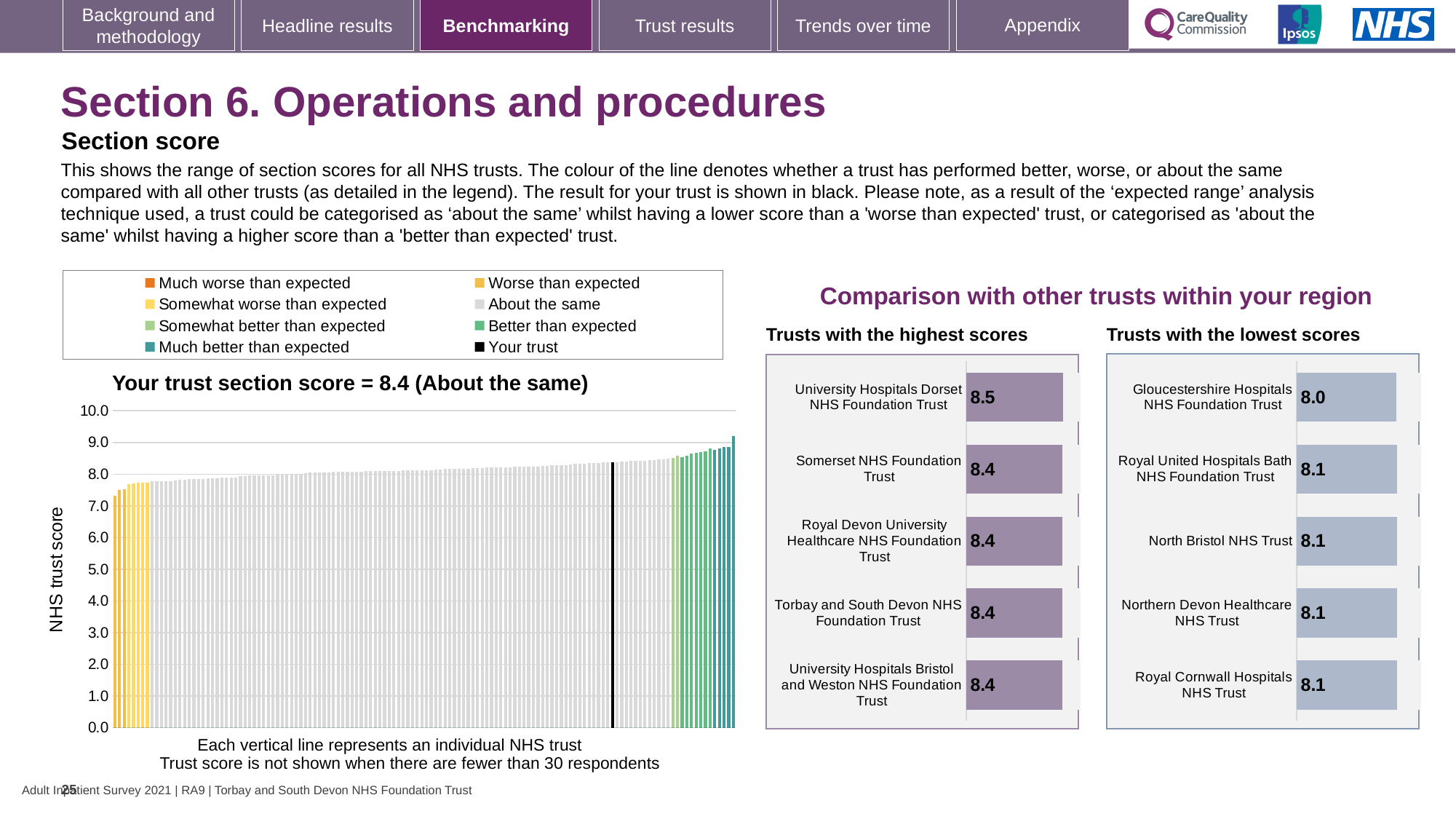
How many trusts are shown in the 'Trusts with the lowest scores' chart? 5 In the 'Your trust section score' chart, is the value of the rightmost (highest) bar greater or less than 8.0? greater In the 'Trusts with the highest scores' chart, what is the difference between the scores of University Hospitals Dorset NHS Foundation Trust and Somerset NHS Foundation Trust? 0.1 In the 'Your trust section score' chart, is the value of the leftmost (lowest) bar greater or less than 8.0? less In the 'Trusts with the highest scores' chart, which trust has the highest score? University Hospitals Dorset NHS Foundation Trust In the 'Trusts with the highest scores' chart, what is the score for University Hospitals Dorset NHS Foundation Trust? 8.5 What is the y-axis label of the 'Your trust section score' chart? NHS trust score In the 'Trusts with the lowest scores' chart, which trust has the lowest score? Gloucestershire Hospitals NHS Foundation Trust What kind of chart is the 'Your trust section score' chart? bar chart How many entries does the legend above the 'Your trust section score' chart list? 8 In the 'Your trust section score' chart, do the bars rise or fall from left to right? rise In the 'Your trust section score' chart, what is the section score for your trust? 8.4